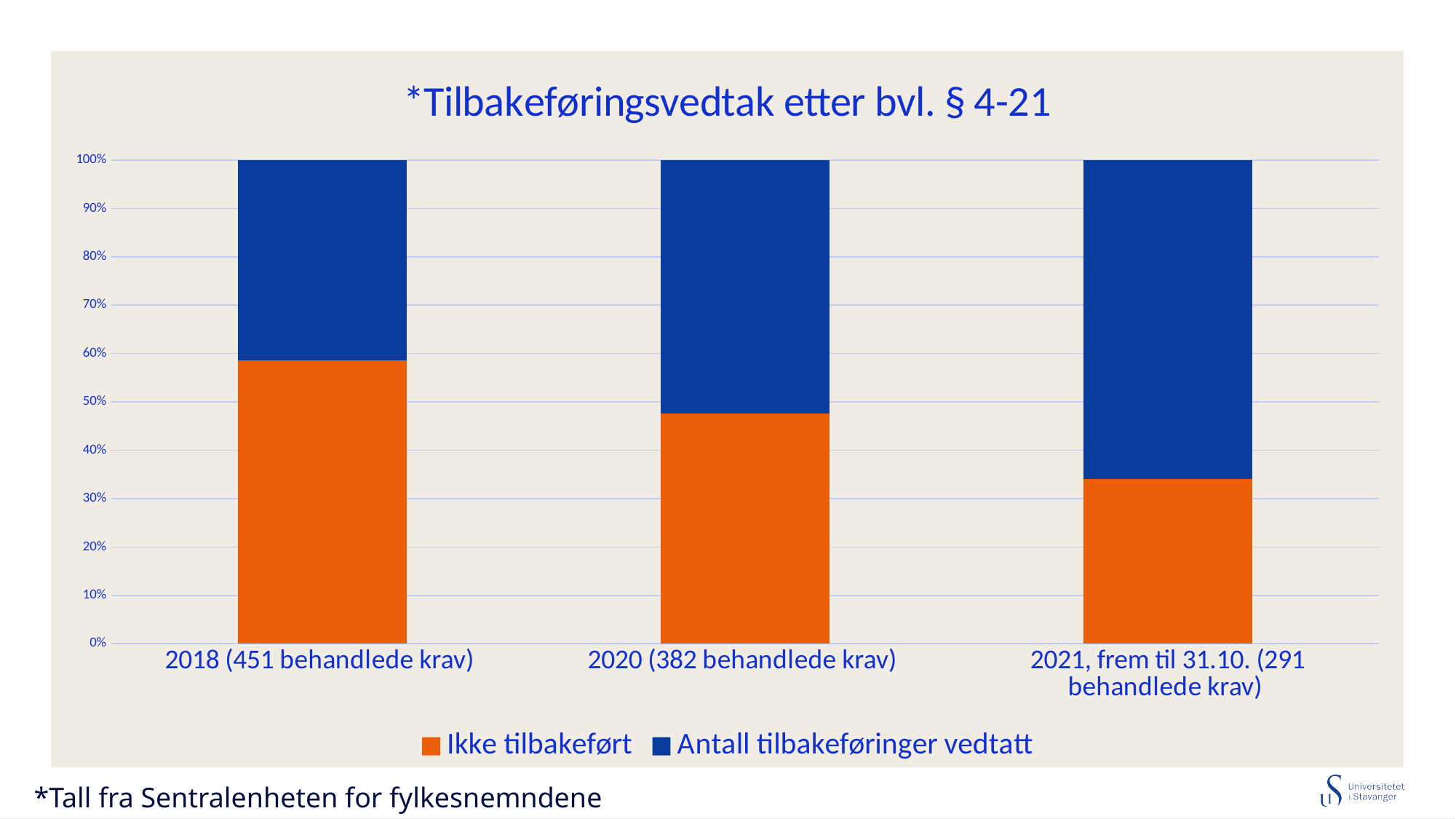
Is the value for Ikke tilbakeført in 2020 (382 behandlede krav) greater or less than 60%? less How many categories are shown on the x axis? 3 In which category is the Ikke tilbakeført share lowest? 2021, frem til 31.10. (291 behandlede krav) Is the value for Ikke tilbakeført in 2021, frem til 31.10. (291 behandlede krav) greater or less than 40%? less In which category is the Ikke tilbakeført share highest? 2018 (451 behandlede krav) How many series does the legend list? 2 What is the title of the chart? *Tilbakeføringsvedtak etter bvl. § 4-21 What kind of chart is shown on the slide? Stacked bar chart Which series is shown in orange in the legend? Ikke tilbakeført Is the Antall tilbakeføringer vedtatt share larger in 2018 (451 behandlede krav) or in 2021, frem til 31.10. (291 behandlede krav)? 2021, frem til 31.10. (291 behandlede krav) Is the value for Ikke tilbakeført in 2018 (451 behandlede krav) greater or less than 50%? greater Does the Ikke tilbakeført share rise or fall from 2018 to 2021 along the x axis? Fall